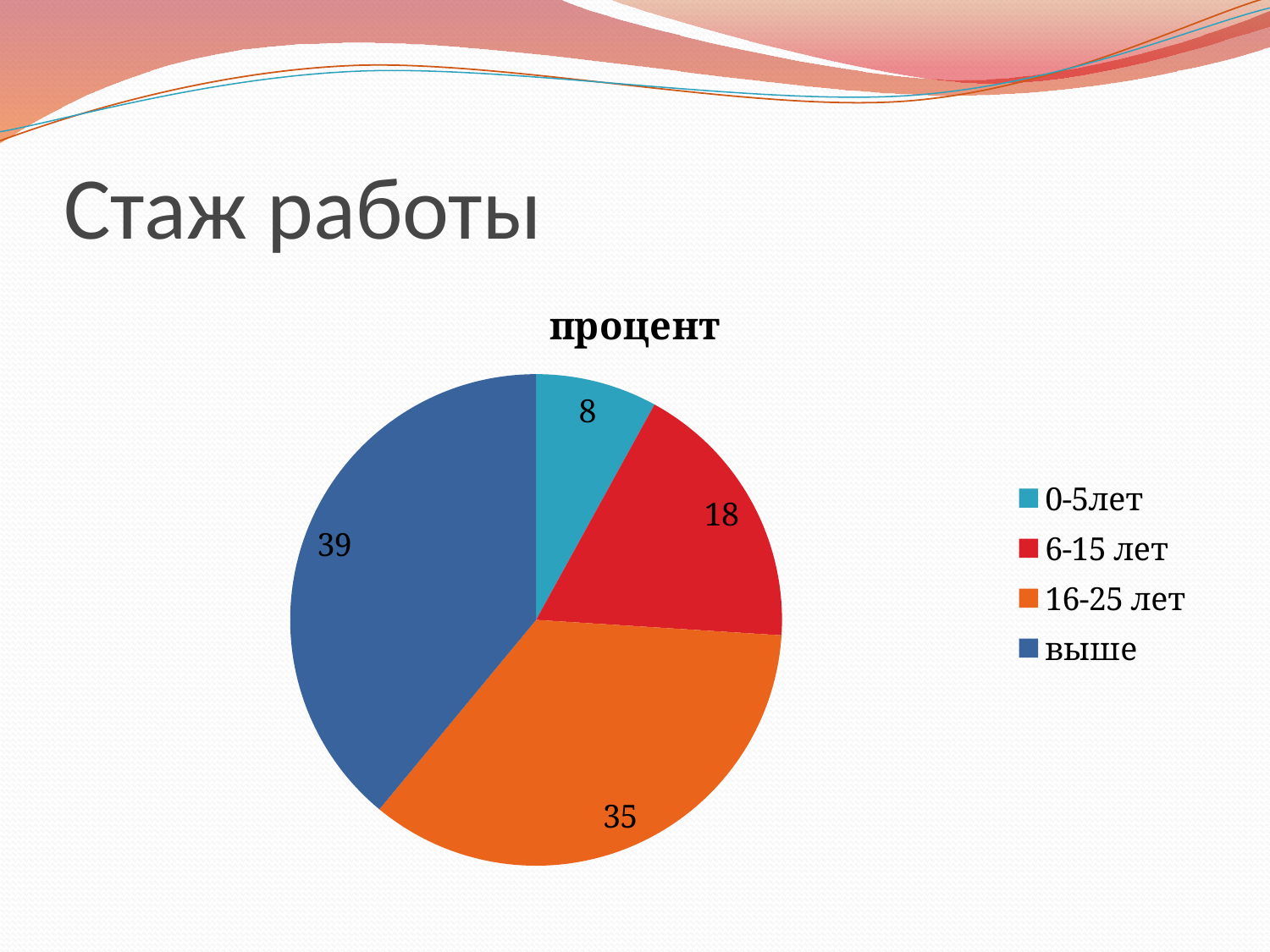
What share of the pie does the выше slice represent? 39% What is the value for the 16-25 лет slice? 35 Which category has the smallest slice? 0-5лет What is the value for the 0-5лет slice? 8 Which category has the largest slice? выше What is the value for the выше slice? 39 What is the difference between the values for выше and 16-25 лет? 4 What is the title of the chart? процент What is the value for the 6-15 лет slice? 18 Which is larger, the value for 6-15 лет or the value for 0-5лет? 6-15 лет How many categories does the pie chart have? 4 What type of chart is shown on the slide? pie chart